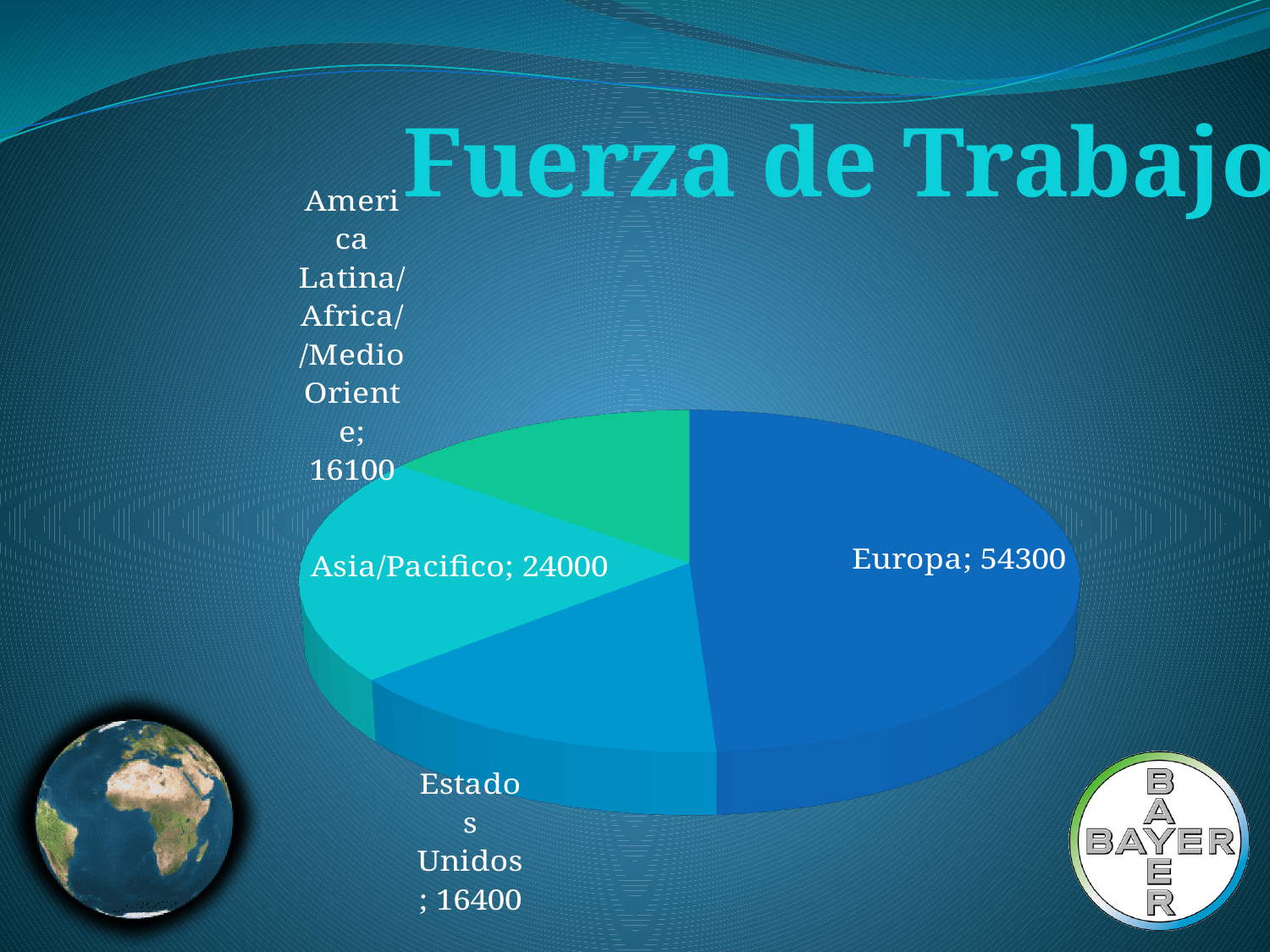
What is the value for Europa in the pie chart? 54300 Which is larger, the value for Asia/Pacifico or the value for Estados Unidos? Asia/Pacifico What kind of chart is shown on the slide? Pie chart What is the value for America Latina/Africa//Medio Oriente in the pie chart? 16100 What is the difference between the values for Estados Unidos and America Latina/Africa//Medio Oriente? 300 Which region has the smallest value in the pie chart? America Latina/Africa//Medio Oriente What is the title of the slide containing the chart? Fuerza de Trabajo What is the value for Asia/Pacifico in the pie chart? 24000 Which region has the largest slice of the pie chart? Europa How many slices does the pie chart have? 4 What is the value for Estados Unidos in the pie chart? 16400 What is the difference between the values for Europa and Asia/Pacifico? 30300